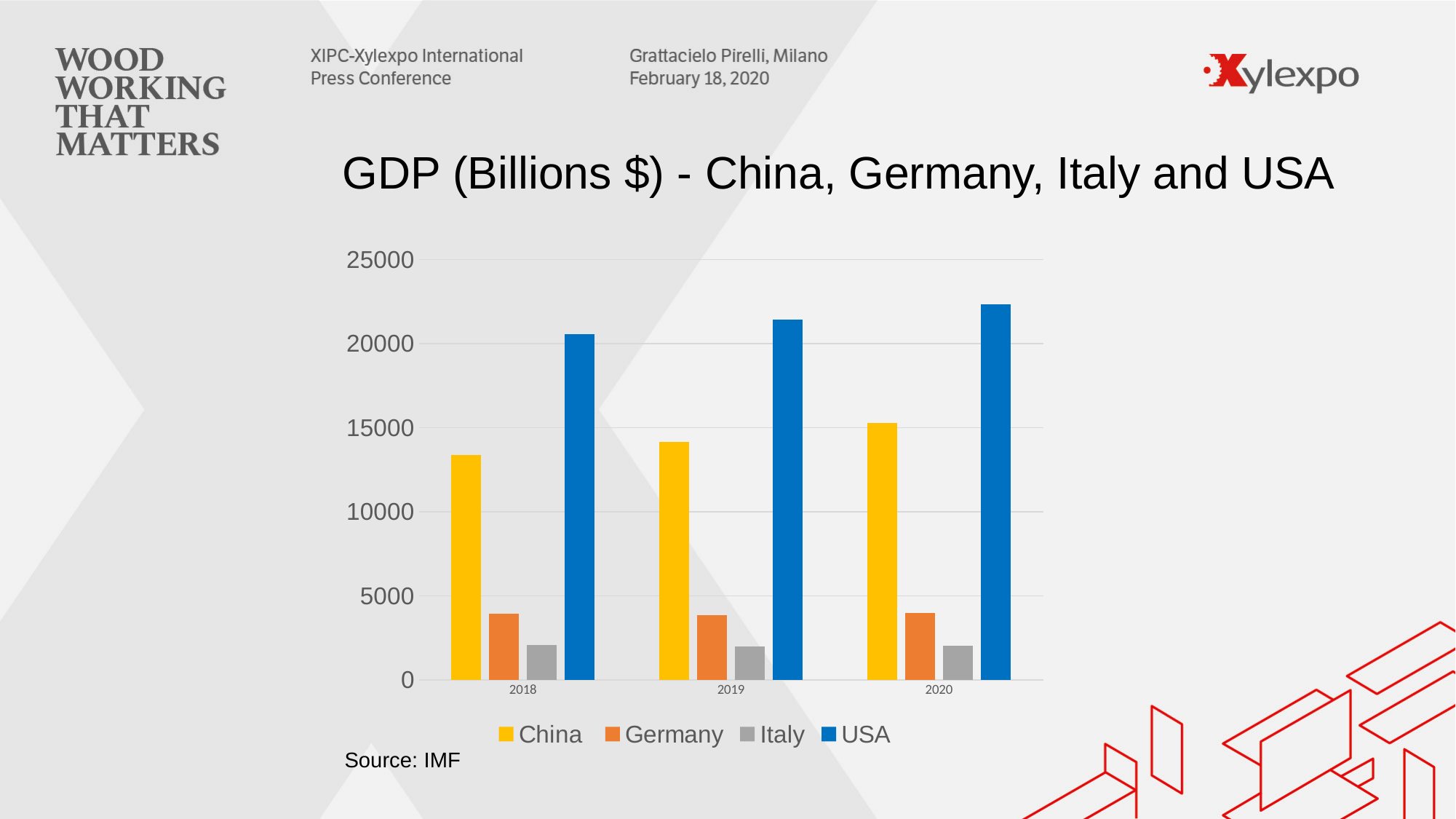
How many years are shown on the x axis? 3 Which country has the lowest GDP in 2018? Italy What is the title of the chart? GDP (Billions $) - China, Germany, Italy and USA What kind of chart is shown on the slide? bar chart Is the GDP of Germany in 2019 greater or less than 5000? less Which country has the highest GDP in 2020? USA Is the GDP of China in 2018 greater or less than 15000? less Is the GDP of the USA in 2020 greater or less than 20000? greater How many series does the legend list? 4 Which is larger, the GDP of Germany in 2020 or the GDP of Italy in 2020? Germany Does the GDP of China rise or fall from 2018 to 2020? rise